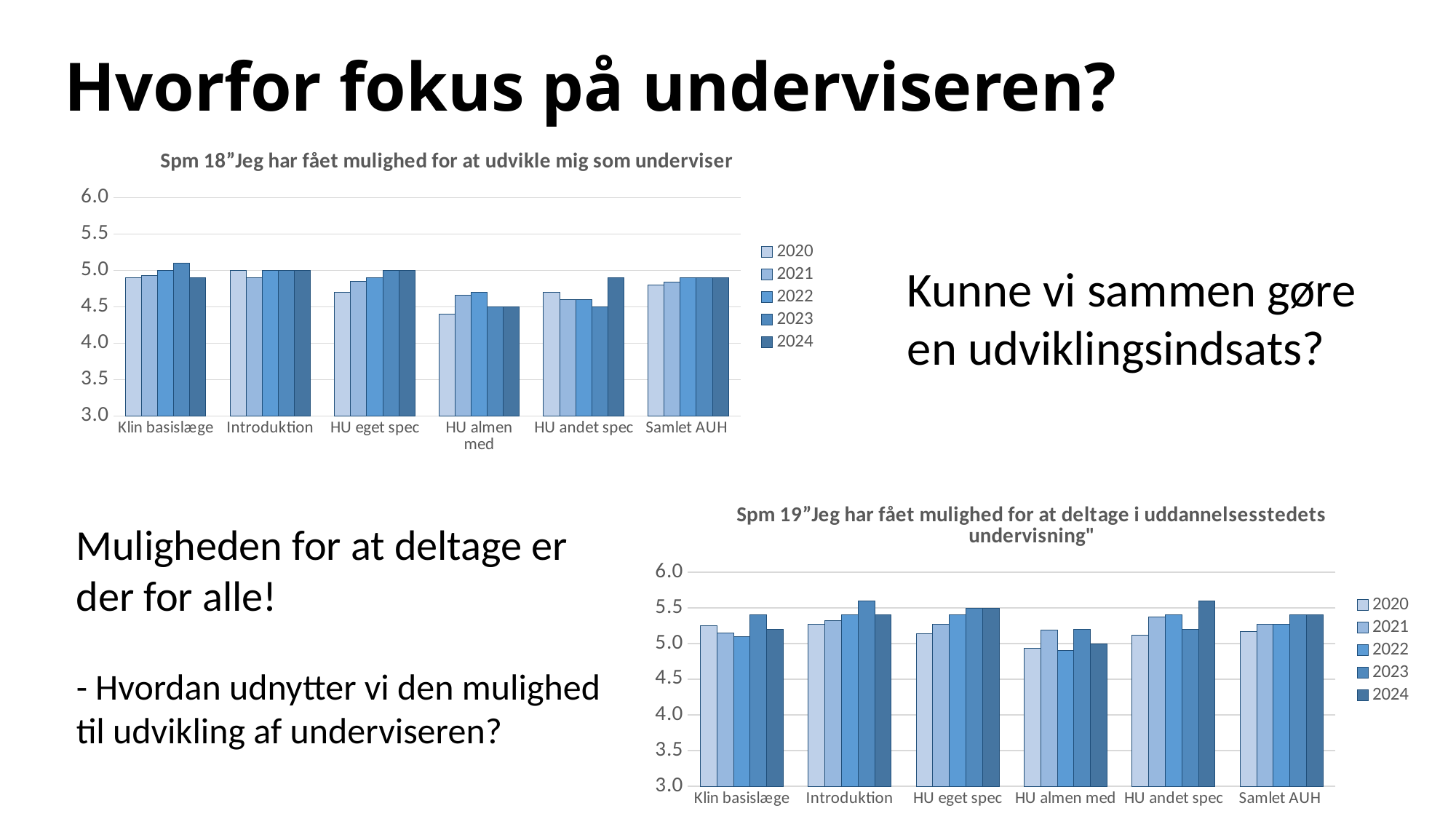
In the bottom chart, "Spm 19", which category has the lowest 2022 value? HU almen med In the bottom chart, "Spm 19", is the 2022 value for HU almen med greater or less than 5.0? less How many series does the legend of the top chart, "Spm 18", list? 5 Which years are listed in the legend of the bottom chart, "Spm 19"? 2020, 2021, 2022, 2023, 2024 In the top chart, "Spm 18", which is larger: the 2020 value for HU almen med or the 2023 value for Klin basislæge? 2023 value for Klin basislæge How many categories are shown on the x axis of the bottom chart, "Spm 19"? 6 In the bottom chart, "Spm 19", is the 2023 value for Introduktion greater or less than 5.5? greater In the top chart, "Spm 18", is the 2020 value for HU almen med greater or less than 4.5? less In the bottom chart, "Spm 19", which is larger: the 2023 value for Introduktion or the 2022 value for HU almen med? 2023 value for Introduktion What kind of chart is the top chart, "Spm 18"? Bar chart